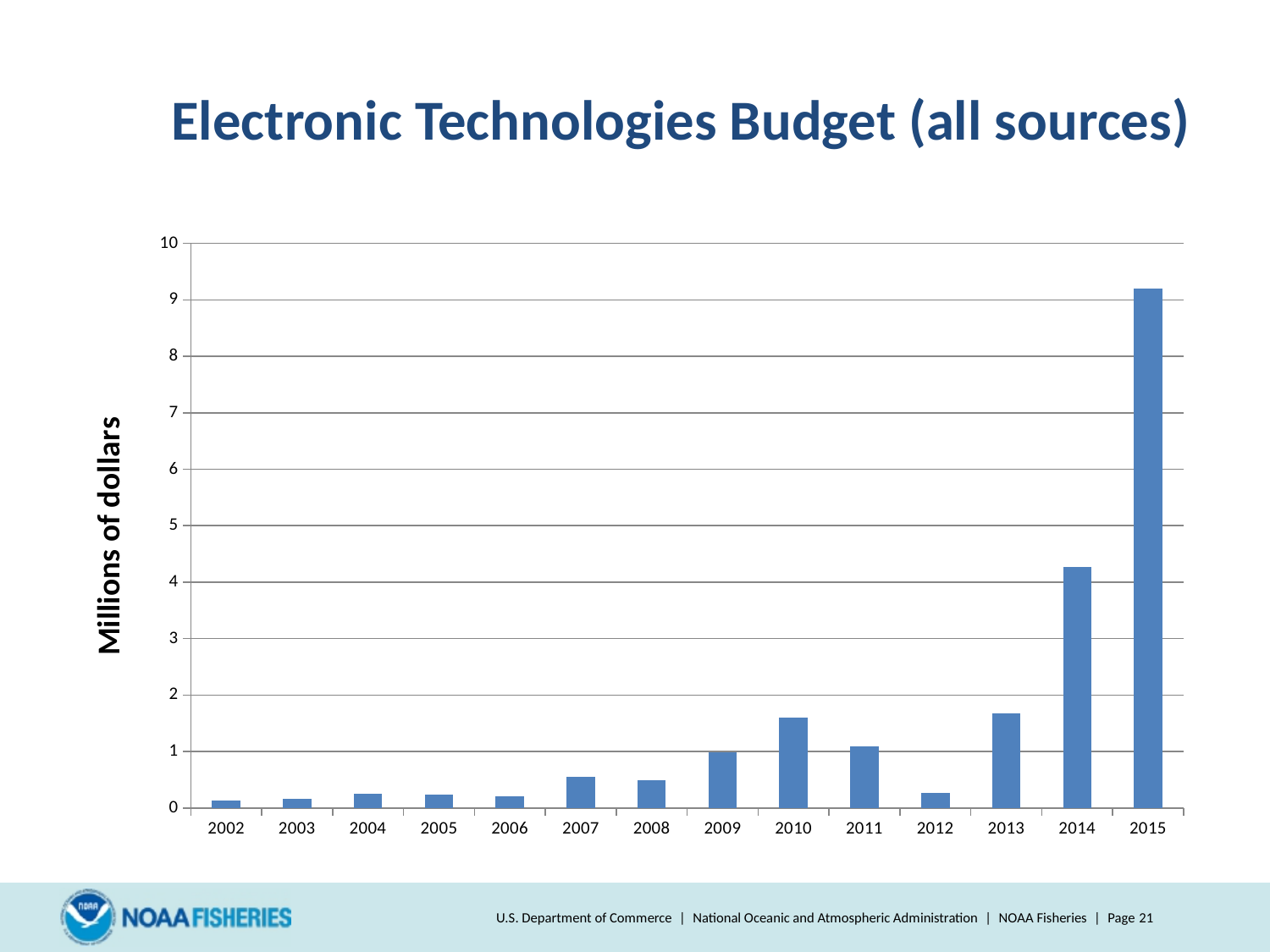
Which year has the larger budget, 2010 or 2011? 2010 Which year has the larger budget, 2014 or 2015? 2015 Is the value for 2014 greater or less than 4? greater How many years are shown on the x axis of the chart? 14 Overall, do the budget values rise or fall from 2002 to 2015? Rise What is the label on the vertical axis of the chart? Millions of dollars Which year has the highest Electronic Technologies Budget? 2015 Is the value for 2015 greater or less than 9? greater What kind of chart is shown on the slide? Bar chart Is the value for 2012 greater or less than 1? less